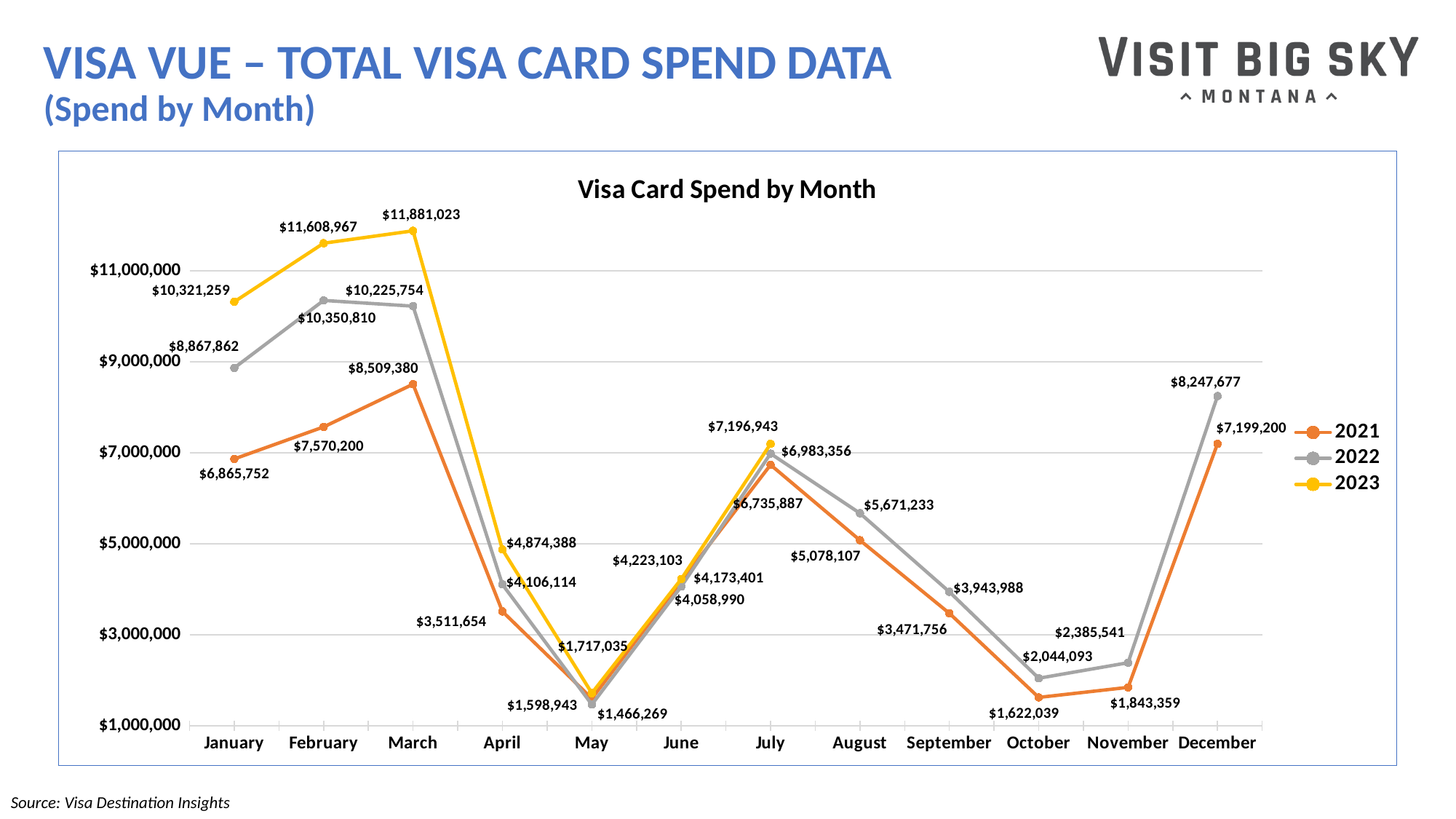
In which month was the 2022 spend lowest? May What type of chart is shown on the slide? Line chart How many series does the legend list? 3 What was the Visa card spend in October 2021? $1,622,039 Which year had the higher spend in February, 2021 or 2022? 2022 Does the 2022 spend rise or fall from March to May? Fall Is the 2021 spend in August greater or less than $5,000,000? greater In which month was the 2023 spend highest? March What was the Visa card spend in March 2023? $11,881,023 What is the difference between the 2023 and 2022 spend in January? $1,453,397 What was the Visa card spend in December 2022? $8,247,677 How many months are shown on the x axis? 12